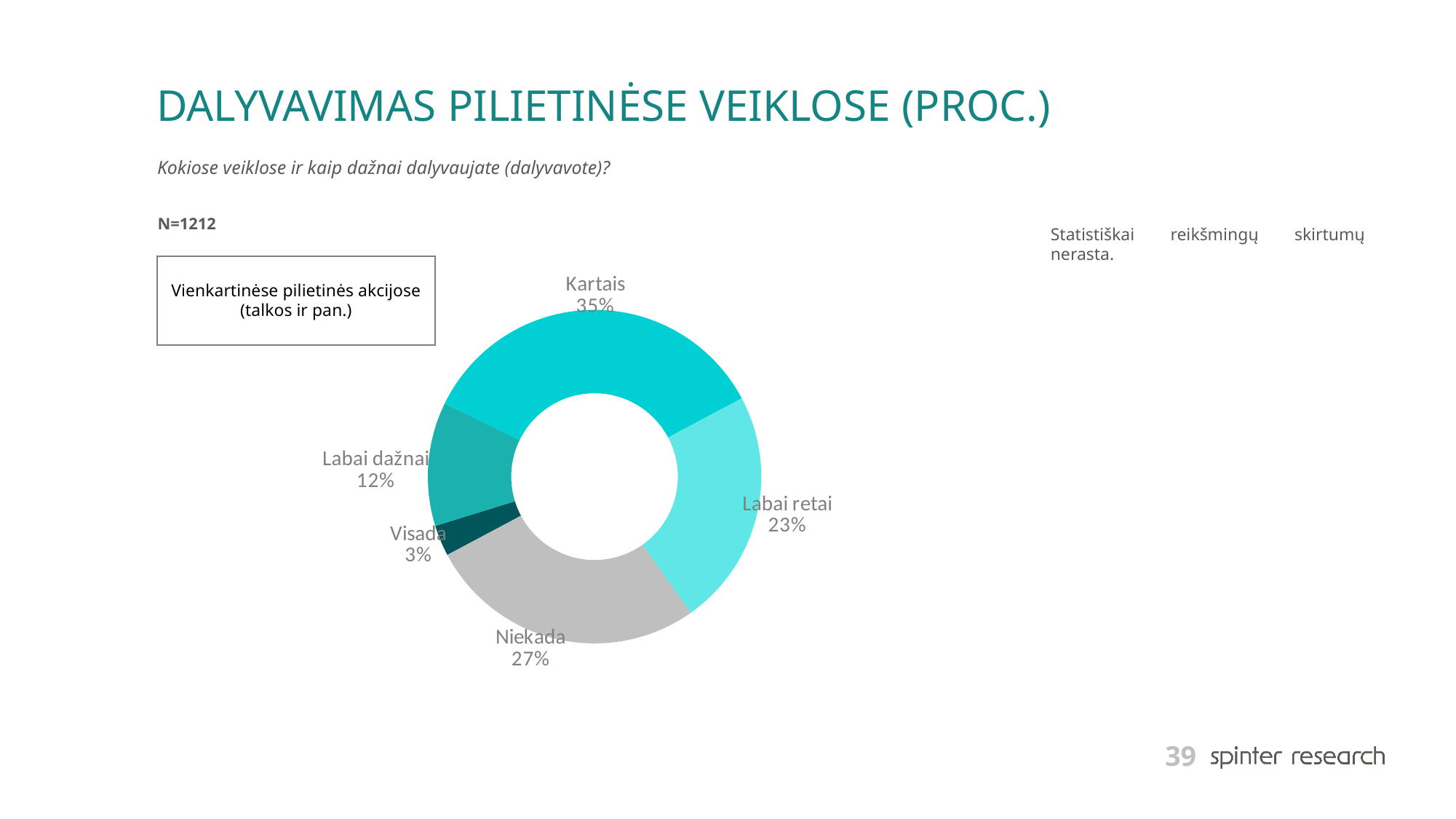
Which category has the largest share of the chart? Kartais What is the difference in percentage points between "Kartais" and "Niekada"? 8 What percentage of respondents answered "Labai retai"? 23% How many categories are shown in the chart? 5 What percentage of respondents answered "Visada"? 3% What is the combined share of "Labai dažnai" and "Visada"? 15% What percentage of respondents answered "Niekada"? 27% What activity is named in the box to the left of the chart? Vienkartinėse pilietinės akcijose (talkos ir pan.) What kind of chart is shown on the slide? Pie chart (doughnut) What percentage of respondents answered "Kartais"? 35% Which is larger, the share for "Labai retai" or the share for "Labai dažnai"? Labai retai Which category has the smallest share of the chart? Visada